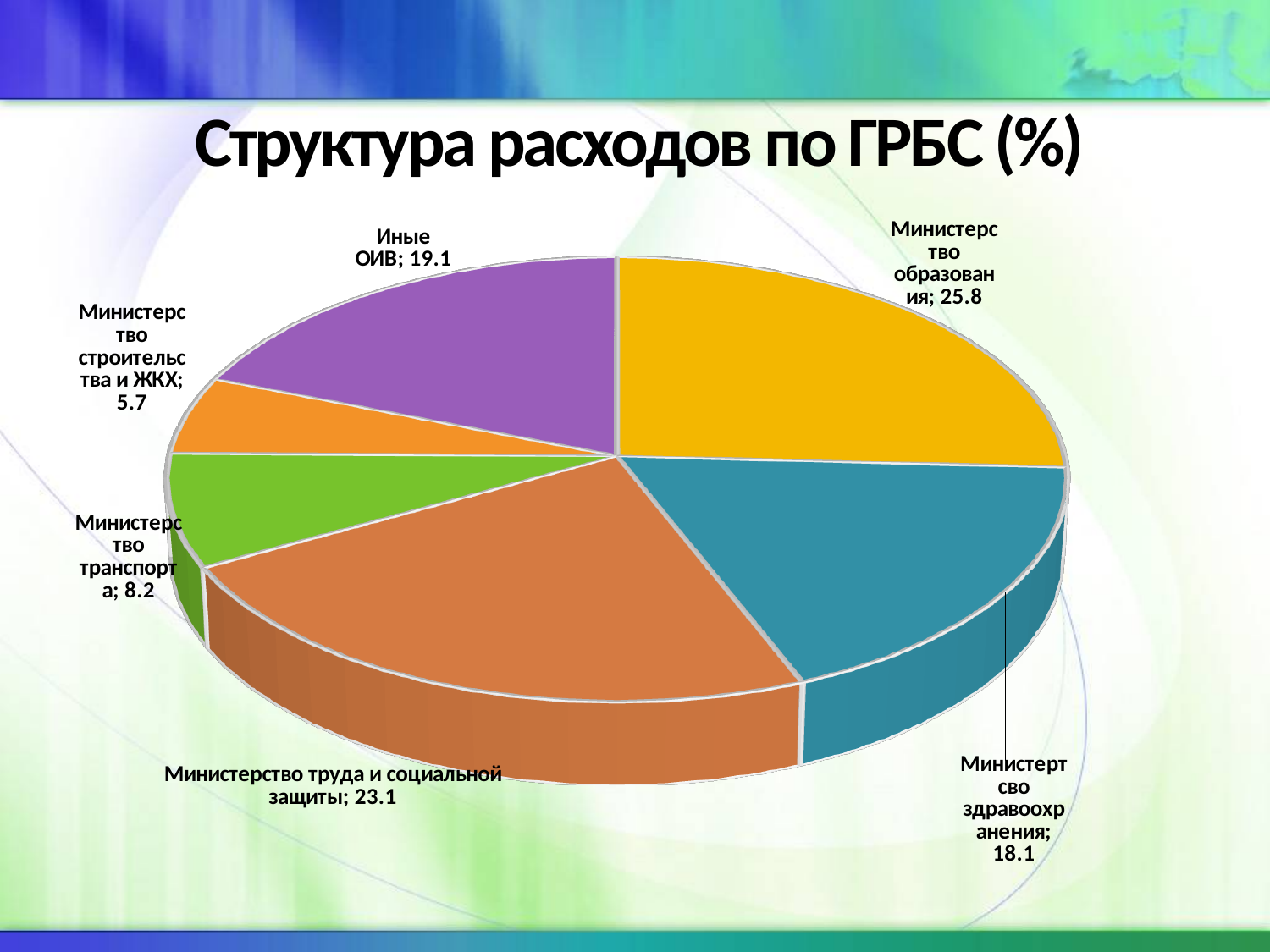
What is the value for Министерство труда и социальной защиты? 23.1 Which category has the largest share of the pie? Министерство образования How many slices does the pie chart have? 6 What is the difference between the values for Министерство образования and Министерство труда и социальной защиты? 2.7 What type of chart is shown on the slide? pie chart What is the value for Иные ОИВ? 19.1 What is the value for Министерство образования? 25.8 Which is larger, the value for Иные ОИВ or the value for Министерство здравоохранения? Иные ОИВ What is the value for Министерство здравоохранения? 18.1 Which category has the smallest share of the pie? Министерство строительства и ЖКХ What is the value for Министерство транспорта? 8.2 What is the title of the chart? Структура расходов по ГРБС (%)